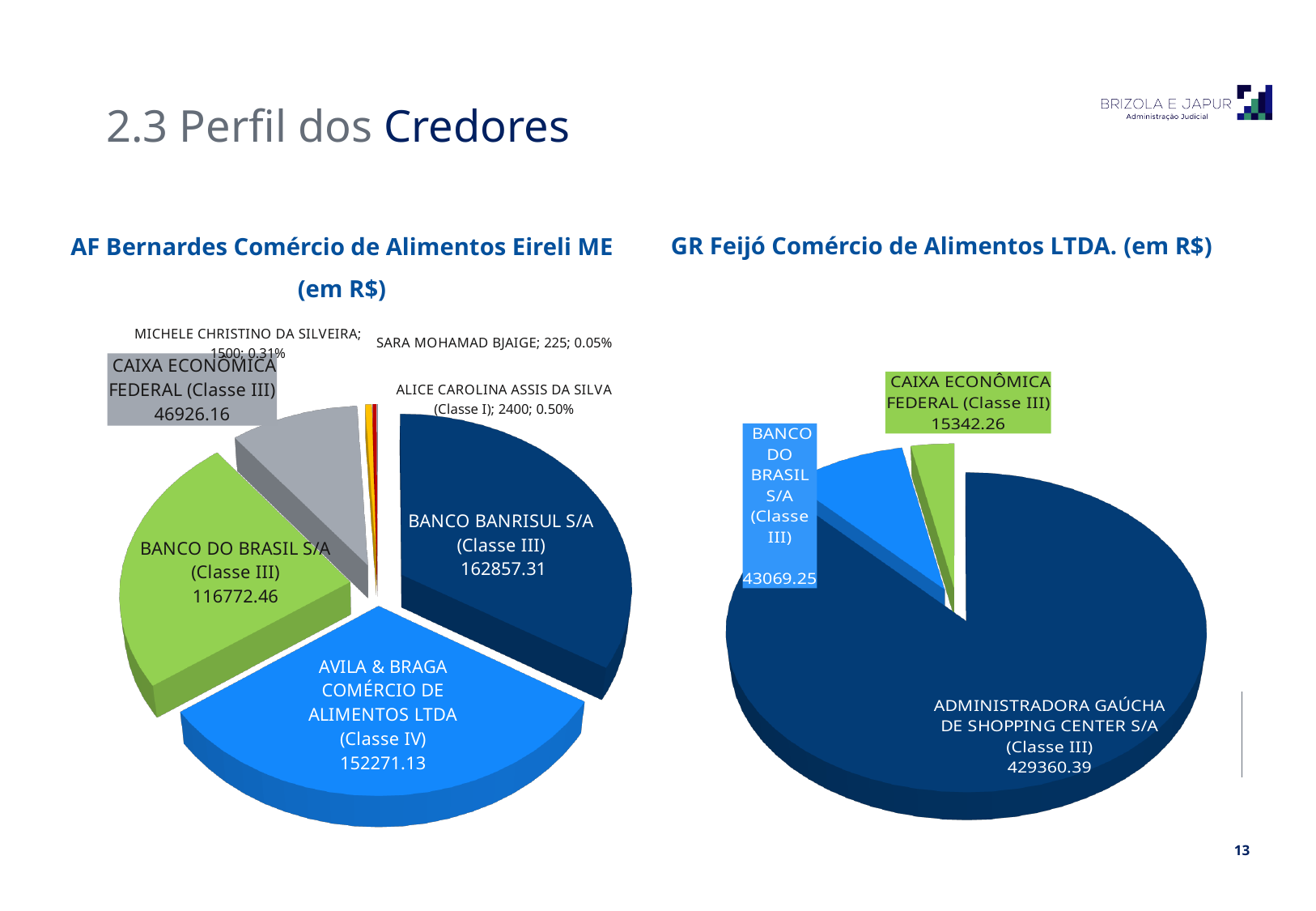
In the AF Bernardes Comércio de Alimentos Eireli ME chart, what is the difference between BANCO BANRISUL S/A (Classe III) and AVILA & BRAGA COMÉRCIO DE ALIMENTOS LTDA (Classe IV)? 10586.18 How many slices does the AF Bernardes Comércio de Alimentos Eireli ME pie chart have? 7 In the GR Feijó Comércio de Alimentos LTDA. chart, what is the difference between BANCO DO BRASIL S/A (Classe III) and CAIXA ECONÔMICA FEDERAL (Classe III)? 27726.99 How many slices does the GR Feijó Comércio de Alimentos LTDA. pie chart have? 3 What type of chart is used on the left for AF Bernardes Comércio de Alimentos Eireli ME? Pie chart In the GR Feijó Comércio de Alimentos LTDA. chart, which creditor has the largest value? ADMINISTRADORA GAÚCHA DE SHOPPING CENTER S/A (Classe III) In the AF Bernardes Comércio de Alimentos Eireli ME chart, what is the value for BANCO BANRISUL S/A (Classe III)? 162857.31 In the AF Bernardes Comércio de Alimentos Eireli ME chart, what share of the pie does MICHELE CHRISTINO DA SILVEIRA represent? 0.31% In the AF Bernardes Comércio de Alimentos Eireli ME chart, what is the value for CAIXA ECONÔMICA FEDERAL (Classe III)? 46926.16 In the AF Bernardes Comércio de Alimentos Eireli ME chart, what is the value for BANCO DO BRASIL S/A (Classe III)? 116772.46 In the GR Feijó Comércio de Alimentos LTDA. chart, what is the value for ADMINISTRADORA GAÚCHA DE SHOPPING CENTER S/A (Classe III)? 429360.39 In the AF Bernardes Comércio de Alimentos Eireli ME chart, which creditor has the smallest value? SARA MOHAMAD BJAIGE